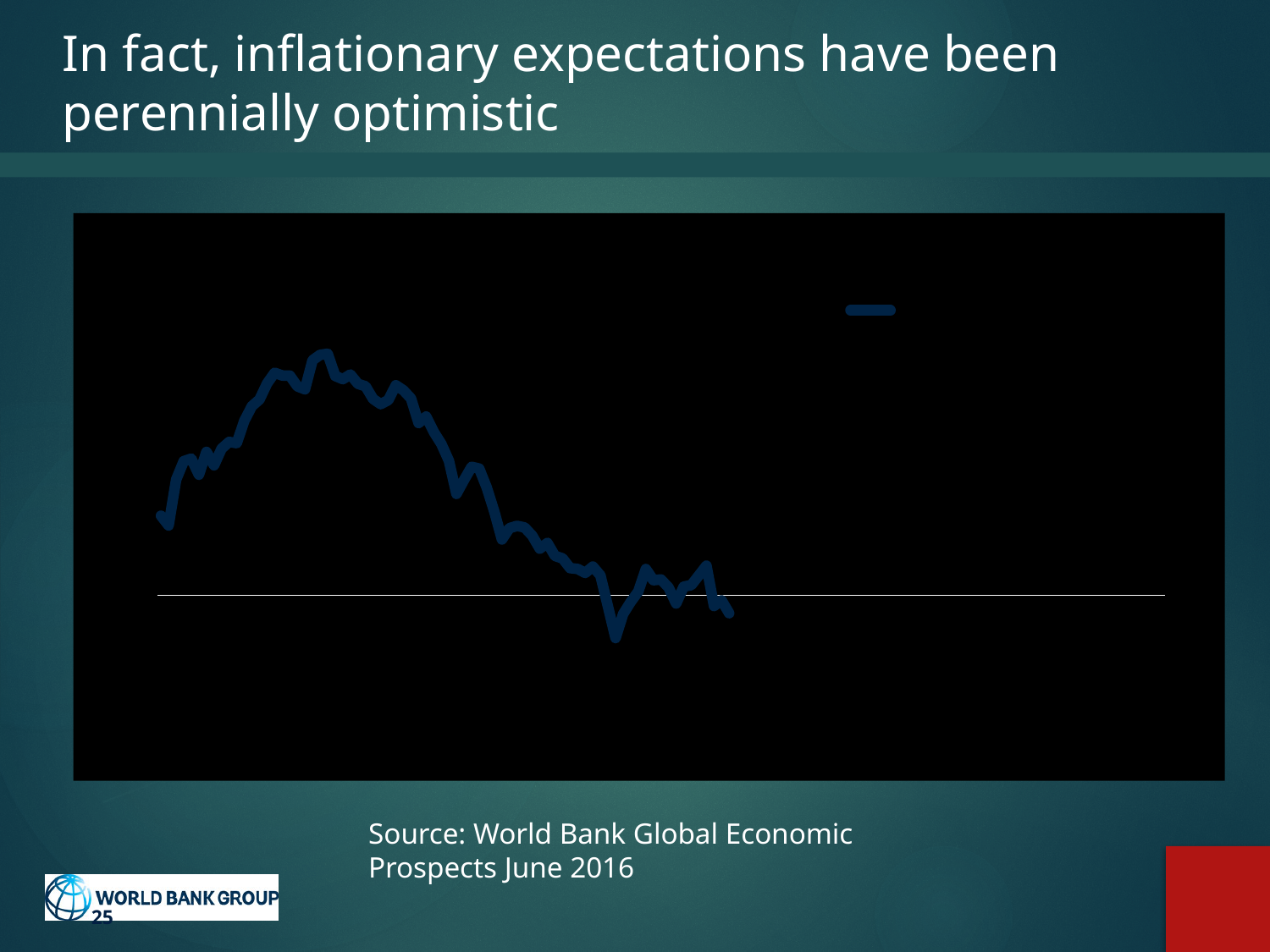
What kind of chart is shown on the slide? line chart Does the line reach its peak in the left half or the right half of the chart? left half Does the plotted line end higher or lower than where it starts? lower How many data series are plotted on the chart? 1 Does the line dip below the horizontal reference line at any point? yes